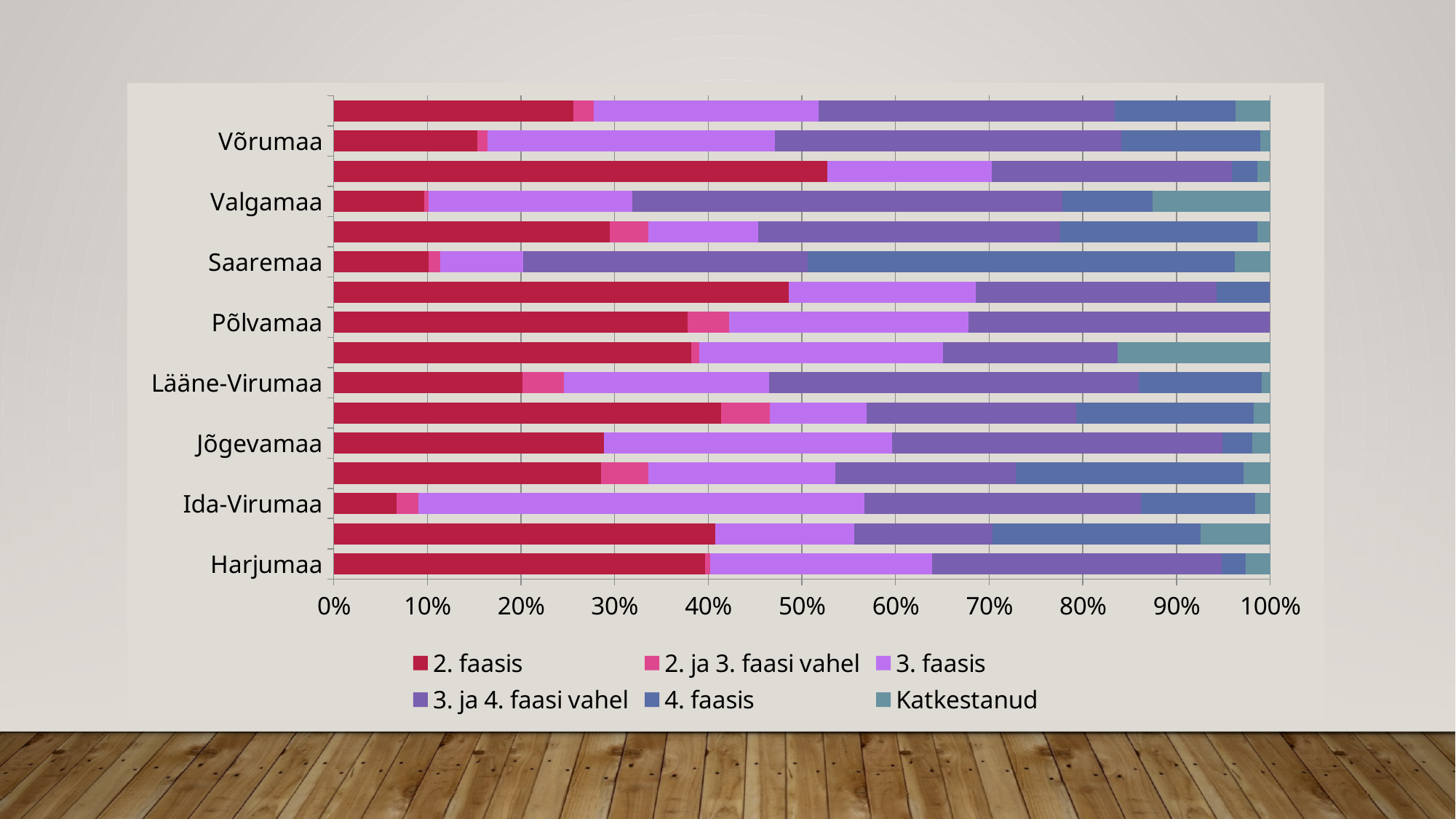
What kind of chart is shown on the slide? Stacked bar chart What is the last series listed in the legend? Katkestanud Is the value for 4. faasis for Saaremaa greater or less than 40%? greater Is the value for 2. faasis for Harjumaa greater or less than 30%? greater Which series is listed first in the legend? 2. faasis Is the value for 2. faasis for Võrumaa greater or less than 20%? less How many category labels are shown on the vertical axis? 8 How many series does the legend list? 6 Which has a larger 2. faasis value, Harjumaa or Ida-Virumaa? Harjumaa